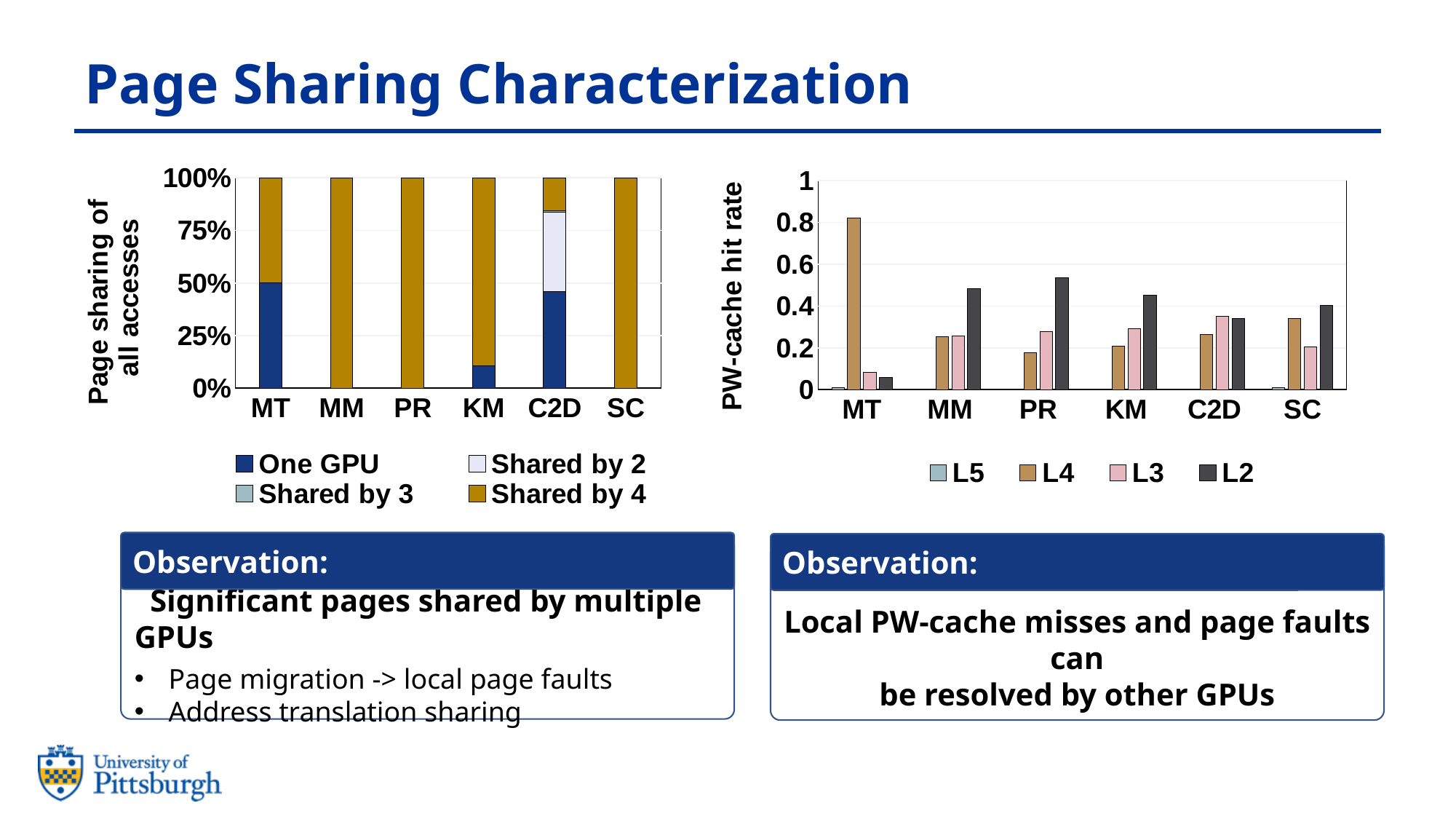
What kind of chart is the left chart, with the y axis labelled 'Page sharing of all accesses'? stacked bar chart How many series does the legend of the left chart (Page sharing of all accesses) list? 4 In the left chart (Page sharing of all accesses), is the 'One GPU' value for KM greater or less than 25%? less In the left chart (Page sharing of all accesses), what is the total height of the stacked bar for MM? 100% In the right chart (PW-cache hit rate), which series has the highest value for MT? L4 In the right chart (PW-cache hit rate), is the L4 value for MT greater or less than 0.8? greater In the left chart (Page sharing of all accesses), is the 'One GPU' value for C2D greater or less than 25%? greater In the right chart (PW-cache hit rate), which is larger for PR: the L2 value or the L3 value? L2 What kind of chart is the right chart, with the y axis labelled 'PW-cache hit rate'? bar chart How many series does the legend of the right chart (PW-cache hit rate) list? 4 How many categories are shown on the x axis of the left chart (Page sharing of all accesses)? 6